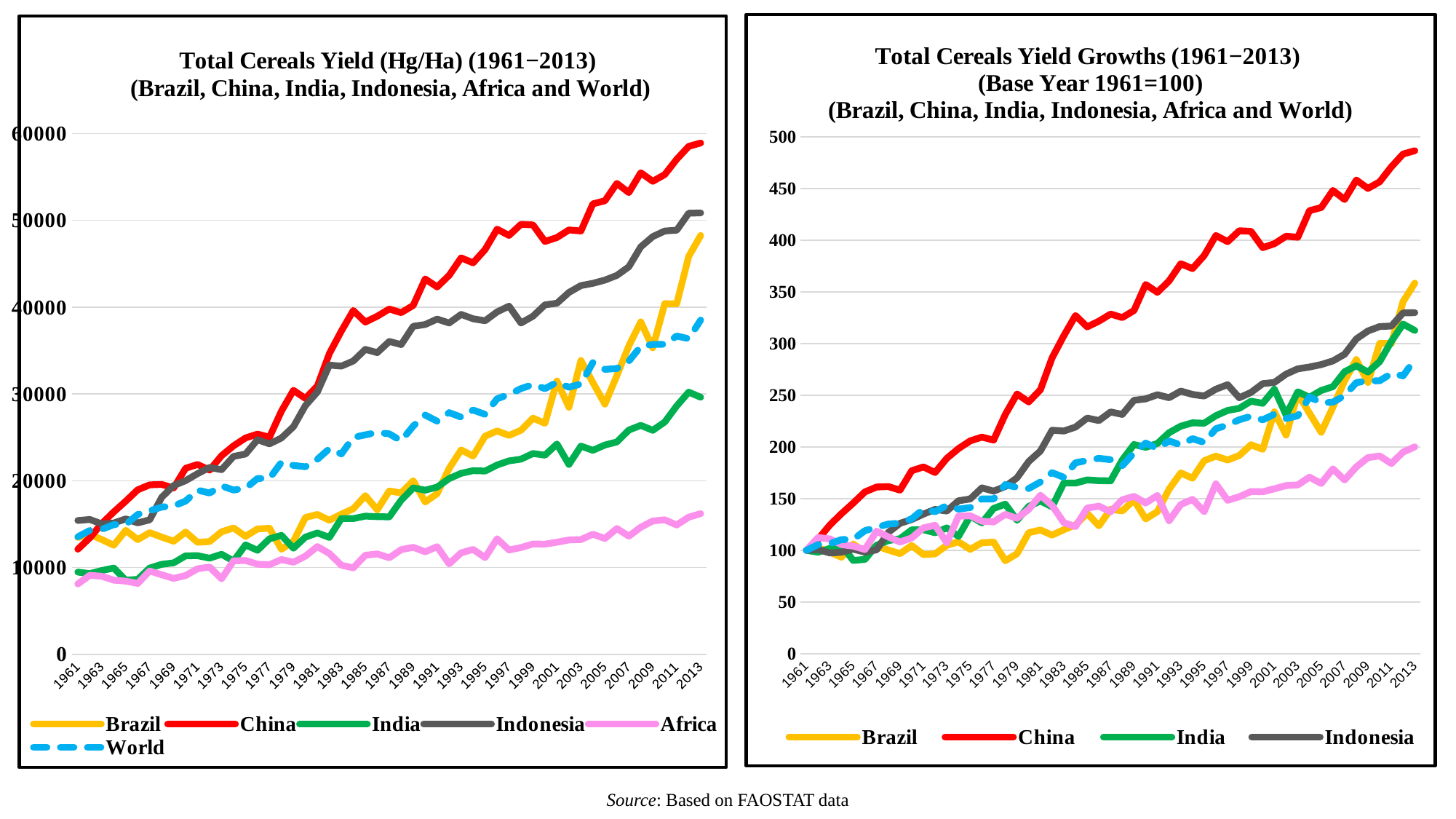
In the left chart, 'Total Cereals Yield (Hg/Ha)', does the yield for China rise or fall from 1961 to 2013? rise What kind of chart is the left chart, 'Total Cereals Yield (Hg/Ha) (1961-2013)'? line chart In the left chart, 'Total Cereals Yield (Hg/Ha)', is the value for Africa in 2013 greater or less than 20000? less How many series does the legend of the right chart, 'Total Cereals Yield Growths', list? 4 In the left chart, 'Total Cereals Yield (Hg/Ha)', which series has the lowest yield in 2013? Africa In the left chart, 'Total Cereals Yield (Hg/Ha)', is the value for China in 2013 greater or less than 50000? greater In the left chart, 'Total Cereals Yield (Hg/Ha)', is the value for India in 2013 greater or less than 40000? less How many series does the legend of the left chart, 'Total Cereals Yield (Hg/Ha)', list? 6 In the right chart, 'Total Cereals Yield Growths', which country has the highest growth index in 2013? China In the left chart, 'Total Cereals Yield (Hg/Ha)', which country has the highest yield in 2013? China